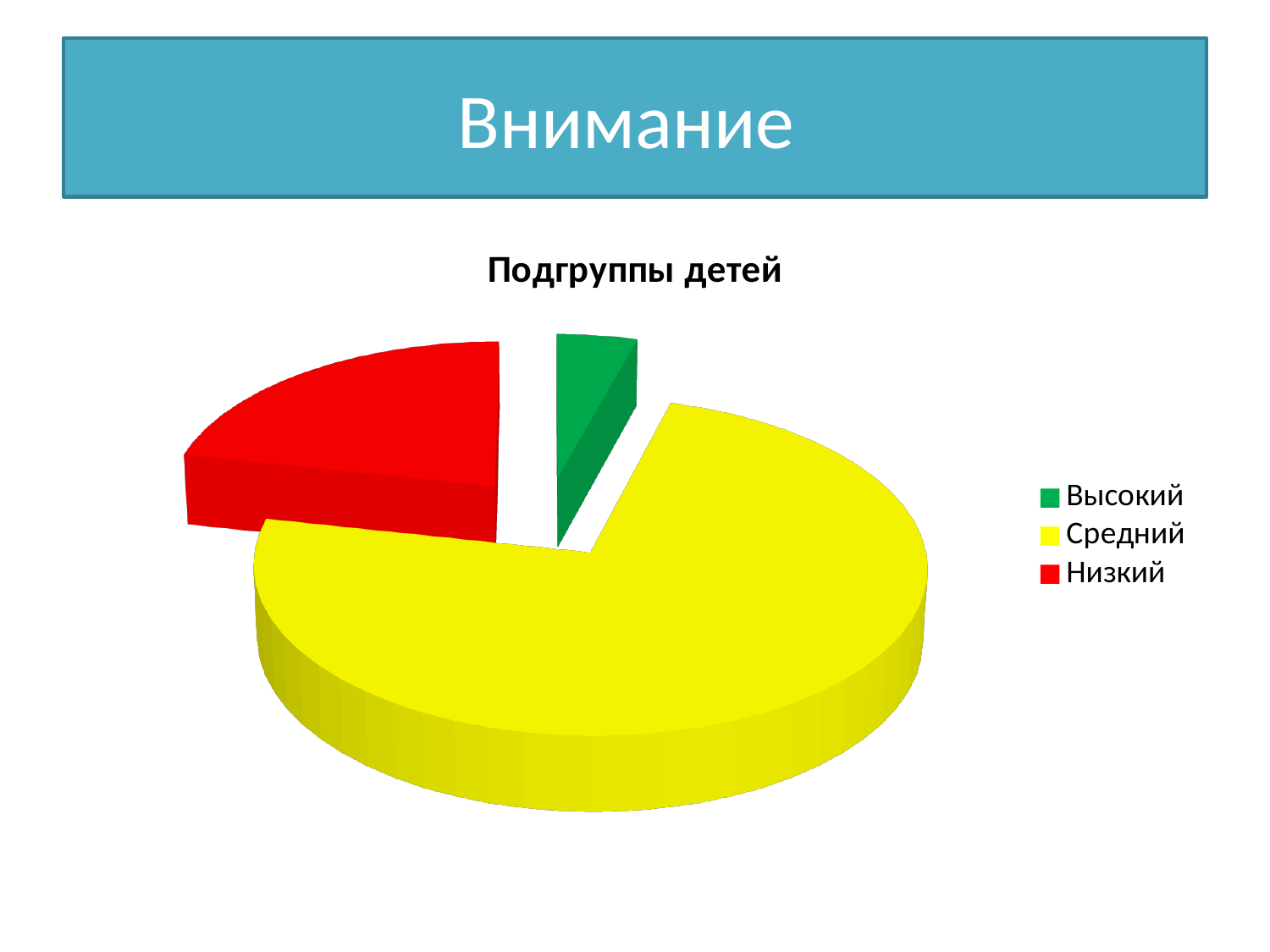
How many entries does the legend list? 3 What kind of chart is shown on the slide? pie chart Which category has the largest slice of the pie? Средний How many slices does the pie chart have? 3 Which slice is larger, Низкий or Высокий? Низкий Which slice is larger, Средний or Низкий? Средний What colour represents the Низкий category in the chart? red Which category has the smallest slice of the pie? Высокий What is the title of the chart? Подгруппы детей